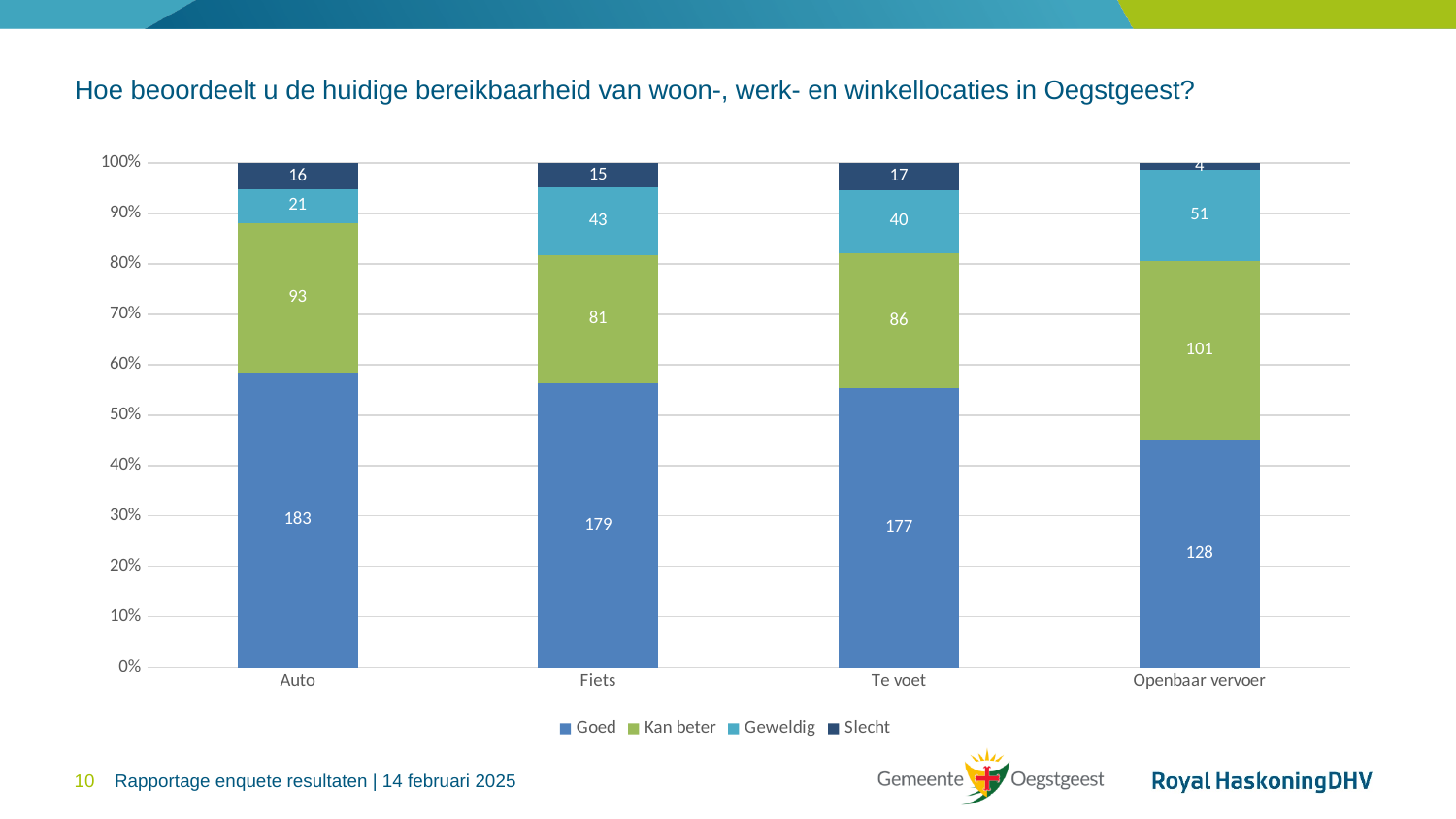
What is the value for Goed in the Auto category? 183 Which category has the highest value for Goed? Auto How many series does the legend list? 4 What is the value for Geweldig in the Fiets category? 43 What is the total of all values in the Fiets bar? 318 What is the value for Slecht in the Te voet category? 17 How many categories are shown on the x axis? 4 Which is larger: the Geweldig value for Te voet or for Openbaar vervoer? Openbaar vervoer Which category has the lowest value for Slecht? Openbaar vervoer What kind of chart is shown on the slide? Stacked bar chart What is the value for Kan beter in the Openbaar vervoer category? 101 What is the difference between the Kan beter values for Auto and Fiets? 12